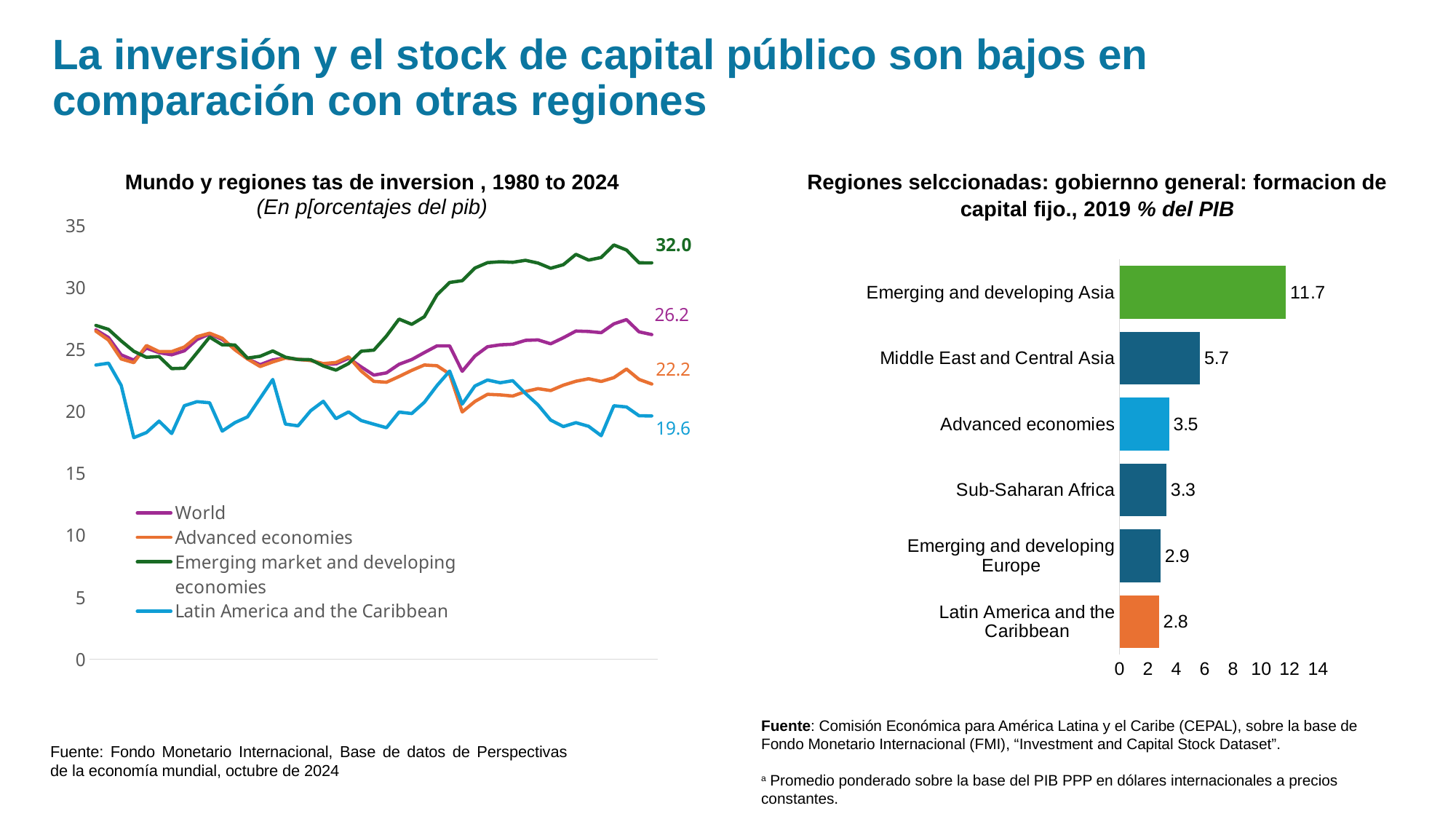
In the left-hand line chart, what is the difference between the final labelled values for World and Advanced economies? 4.0 How many regions are shown in the right-hand bar chart? 6 How many series does the legend of the left-hand line chart list? 4 In the left-hand line chart, what is the final value labelled for Latin America and the Caribbean? 19.6 In the right-hand bar chart, what is the difference between Emerging and developing Asia and Middle East and Central Asia? 6.0 In the right-hand bar chart, what is the value for Latin America and the Caribbean? 2.8 In the right-hand bar chart, which is larger: Advanced economies or Sub-Saharan Africa? Advanced economies What kind of chart is the right-hand chart? Bar chart In the right-hand bar chart, which region has the lowest value? Latin America and the Caribbean In the right-hand bar chart, which region has the highest value? Emerging and developing Asia In the left-hand line chart, what is the final value labelled for Emerging market and developing economies? 32.0 In the right-hand bar chart, what is the value for Emerging and developing Asia? 11.7